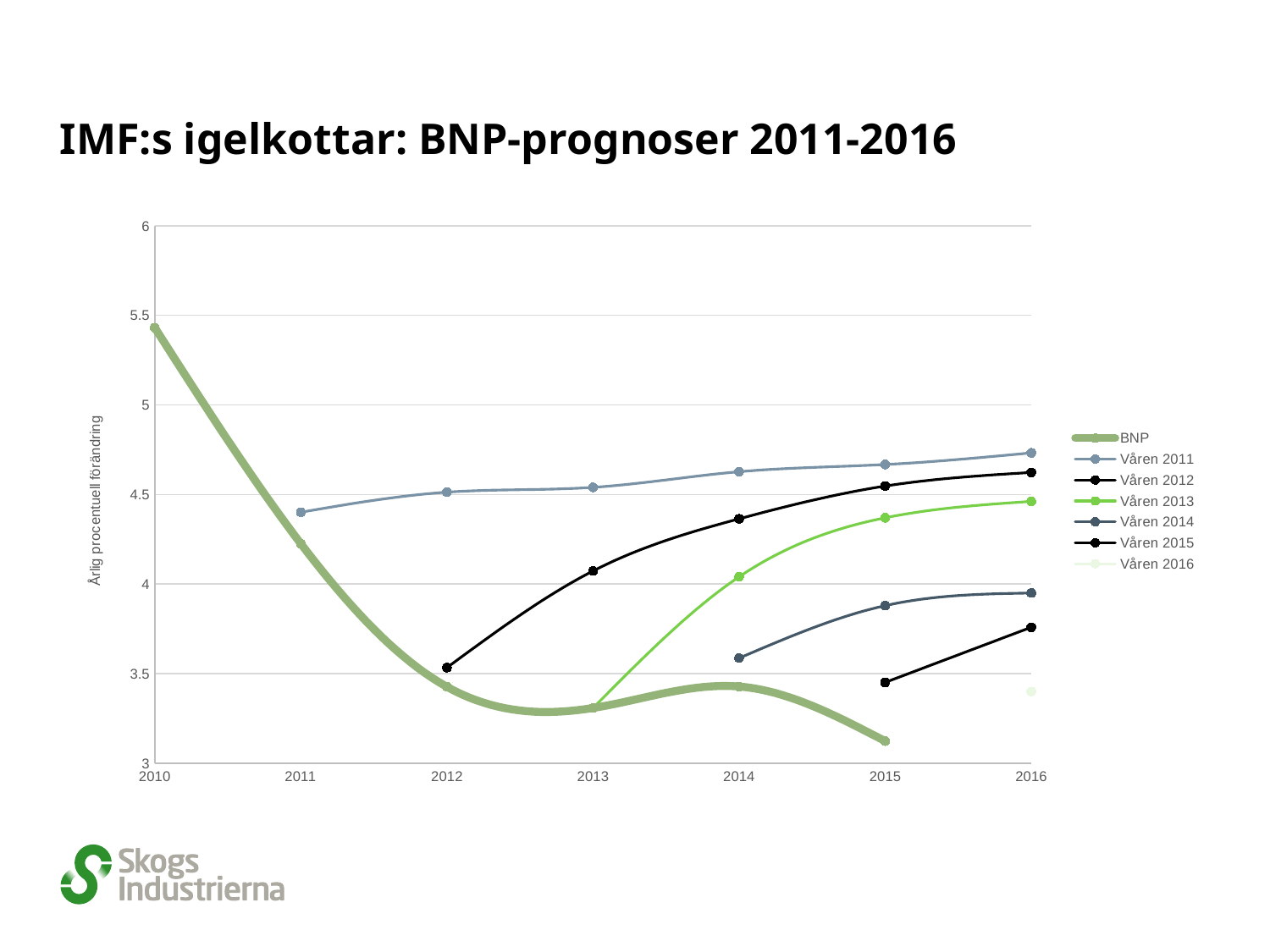
Which series has the lowest value in 2016? Våren 2016 How many years are marked on the x axis? 7 Is the BNP value for 2010 greater or less than 5? greater Is the Våren 2012 value for 2014 greater or less than 4.5? less Is the Våren 2015 value for 2016 greater or less than 4? less In 2016, which is larger: the Våren 2011 value or the Våren 2015 value? Våren 2011 What kind of chart is shown on the slide? line chart Does the BNP line rise or fall from 2010 to 2012? fall Which series has the highest value in 2016? Våren 2011 How many series does the legend list? 7